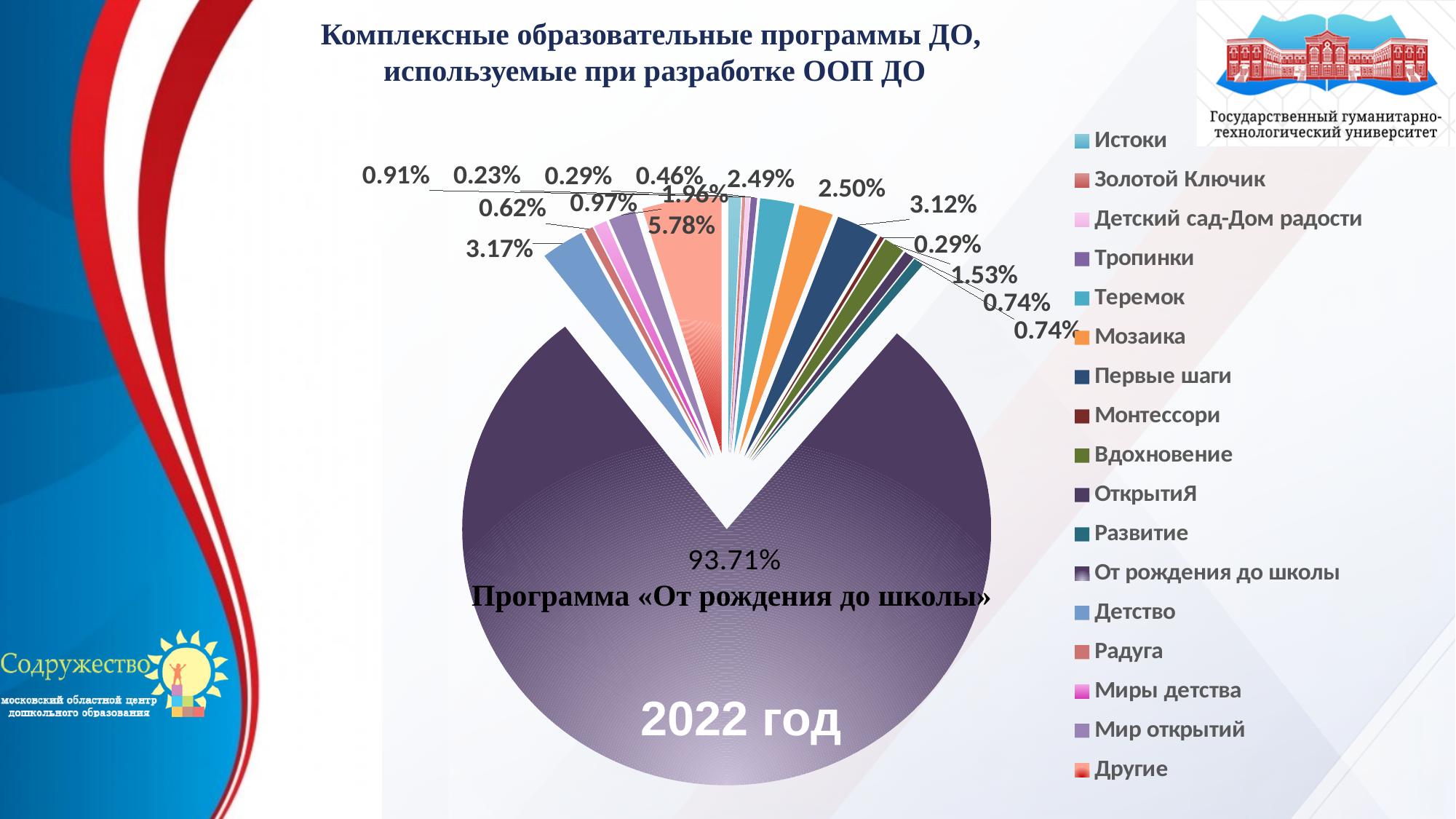
How many entries does the legend list? 17 Which year is the chart labelled with? 2022 год What share of the pie does the program «От рождения до школы» hold? 93.71% What is the value shown for the slice «Детство»? 3.17% Which is larger, the slice for «Другие» or the slice for «Детство»? Другие What kind of chart is shown on the slide? pie chart What is the difference between the share of «От рождения до школы» and the share of «Другие»? 87.93% What is the title of the chart? Комплексные образовательные программы ДО, используемые при разработке ООП ДО Which program has the largest slice of the pie? От рождения до школы What is the value shown for the slice «Другие»? 5.78% What is the value shown for the slice «Первые шаги»? 3.12%